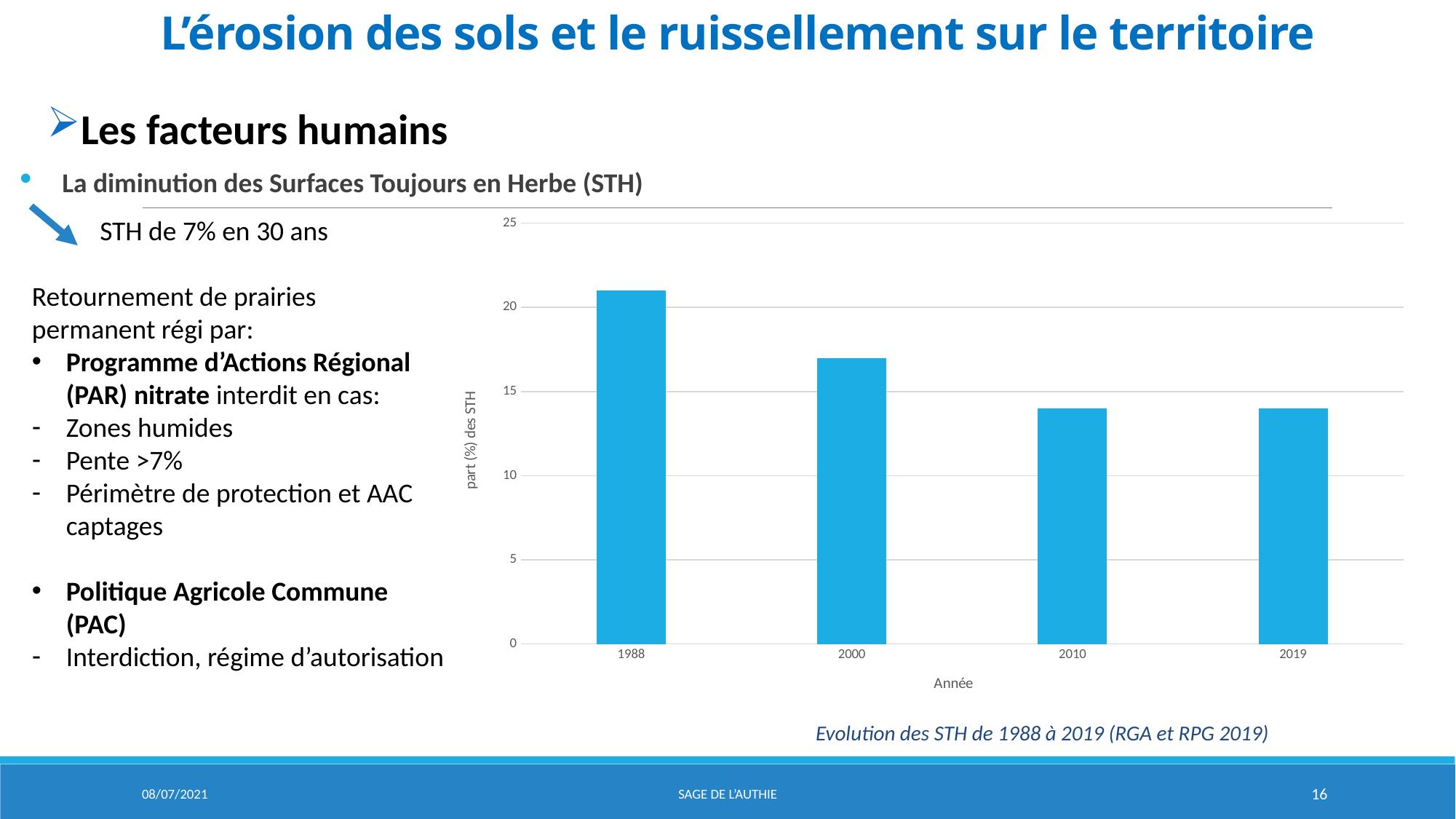
Is the value for 1988 greater or less than 20? greater Is the value for 2019 greater or less than 10? greater Is the value for 2000 greater or less than 20? less Which is larger, the value for 2000 or the value for 2010? 2000 What kind of chart is shown on the slide? bar chart What is the label of the vertical axis of the chart? part (%) des STH Do the values rise or fall from 1988 to 2019 along the x axis? fall Which is larger, the value for 1988 or the value for 2000? 1988 How many years (bars) are plotted on the chart? 4 Which year has the highest share of STH on the chart? 1988